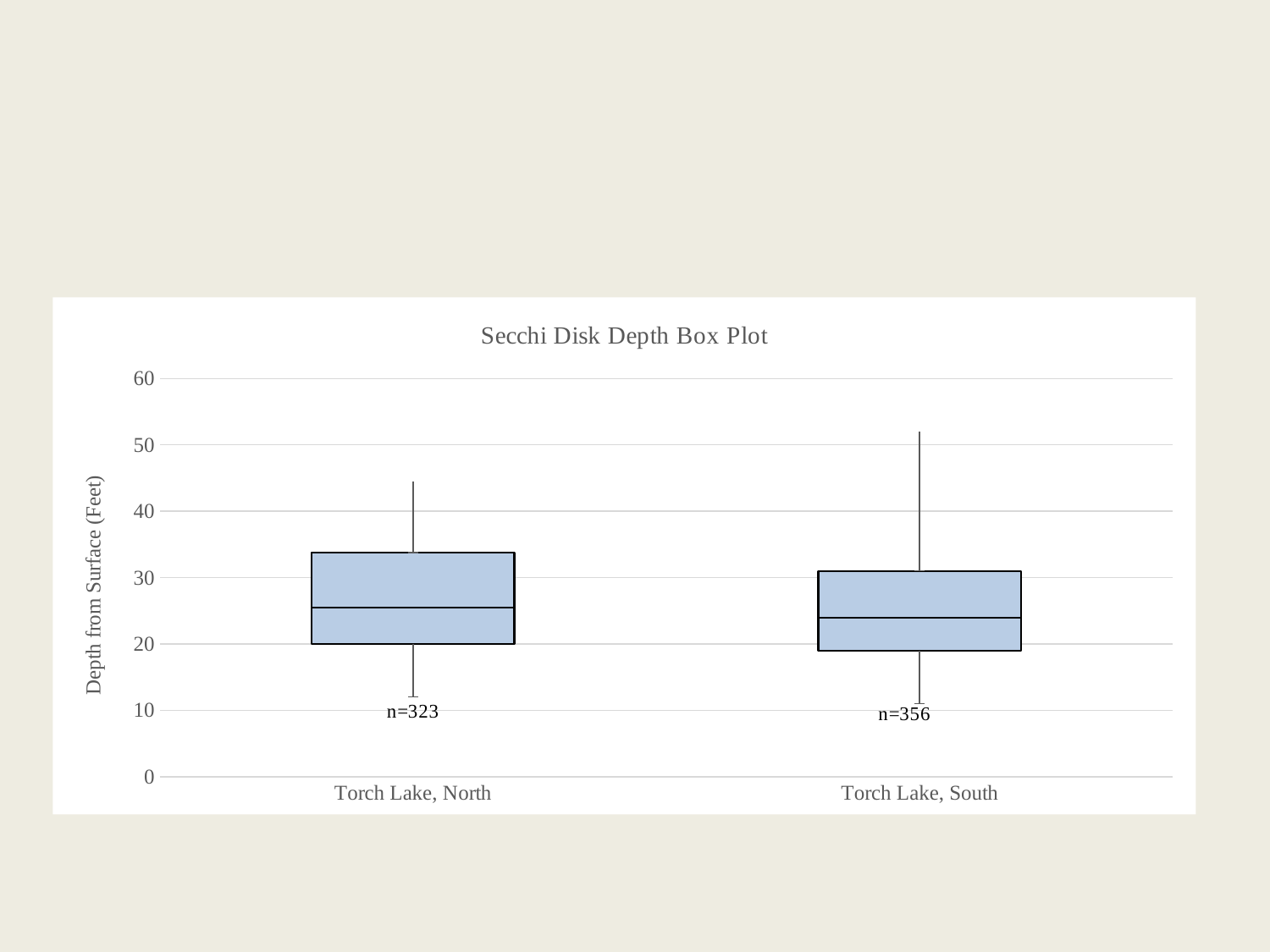
What sample size (n) is printed for Torch Lake, South? n=356 What sample size (n) is printed for Torch Lake, North? n=323 What is the label on the vertical axis of the chart? Depth from Surface (Feet) Is the top of the upper whisker for Torch Lake, South greater or less than 50? greater What kind of chart is shown on the slide? Box plot Which category has the larger sample size, Torch Lake, North or Torch Lake, South? Torch Lake, South What is the difference between the sample sizes of Torch Lake, South and Torch Lake, North? 33 Which category has the higher upper whisker, Torch Lake, North or Torch Lake, South? Torch Lake, South Is the median depth for Torch Lake, South greater or less than 20? greater How many categories are shown on the x axis of the chart? 2 What is the title of the chart? Secchi Disk Depth Box Plot Is the median depth for Torch Lake, North greater or less than 30? less